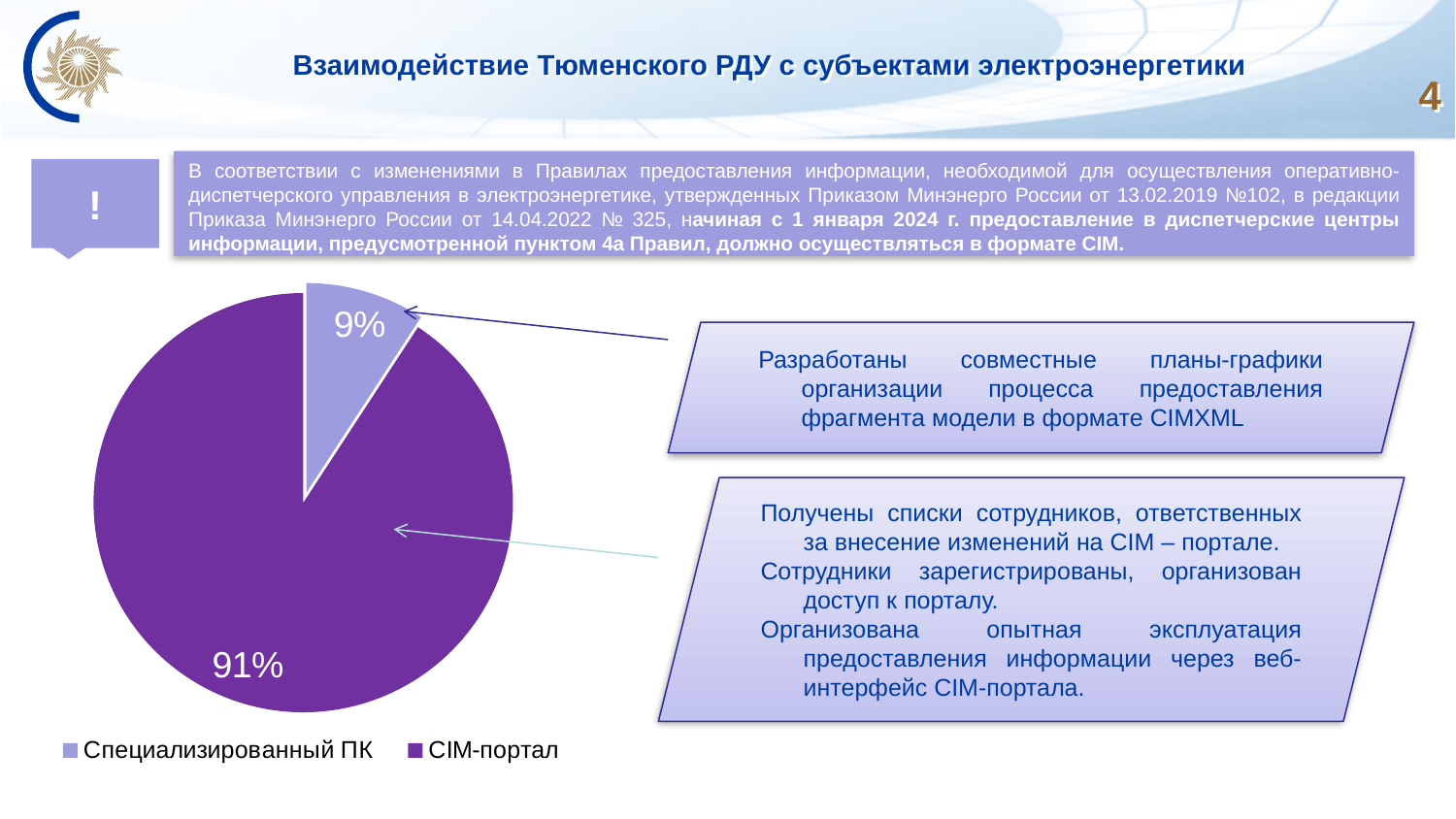
Which slice of the pie chart is the largest? CIM-портал What is the total of the two slices shown in the pie chart? 100% What share of the pie does the Специализированный ПК slice represent? 9% What kind of chart is shown on the slide? pie chart Which is larger: the share for CIM-портал or the share for Специализированный ПК? CIM-портал What is the difference in percentage points between the CIM-портал slice and the Специализированный ПК slice? 82 Is the share for Специализированный ПК greater or less than 10%? less How many slices does the pie chart have? 2 How many entries does the legend of the pie chart list? 2 What share of the pie does the CIM-портал slice represent? 91% Which slice of the pie chart is the smallest? Специализированный ПК Which legend entry is shown in the darker purple colour? CIM-портал